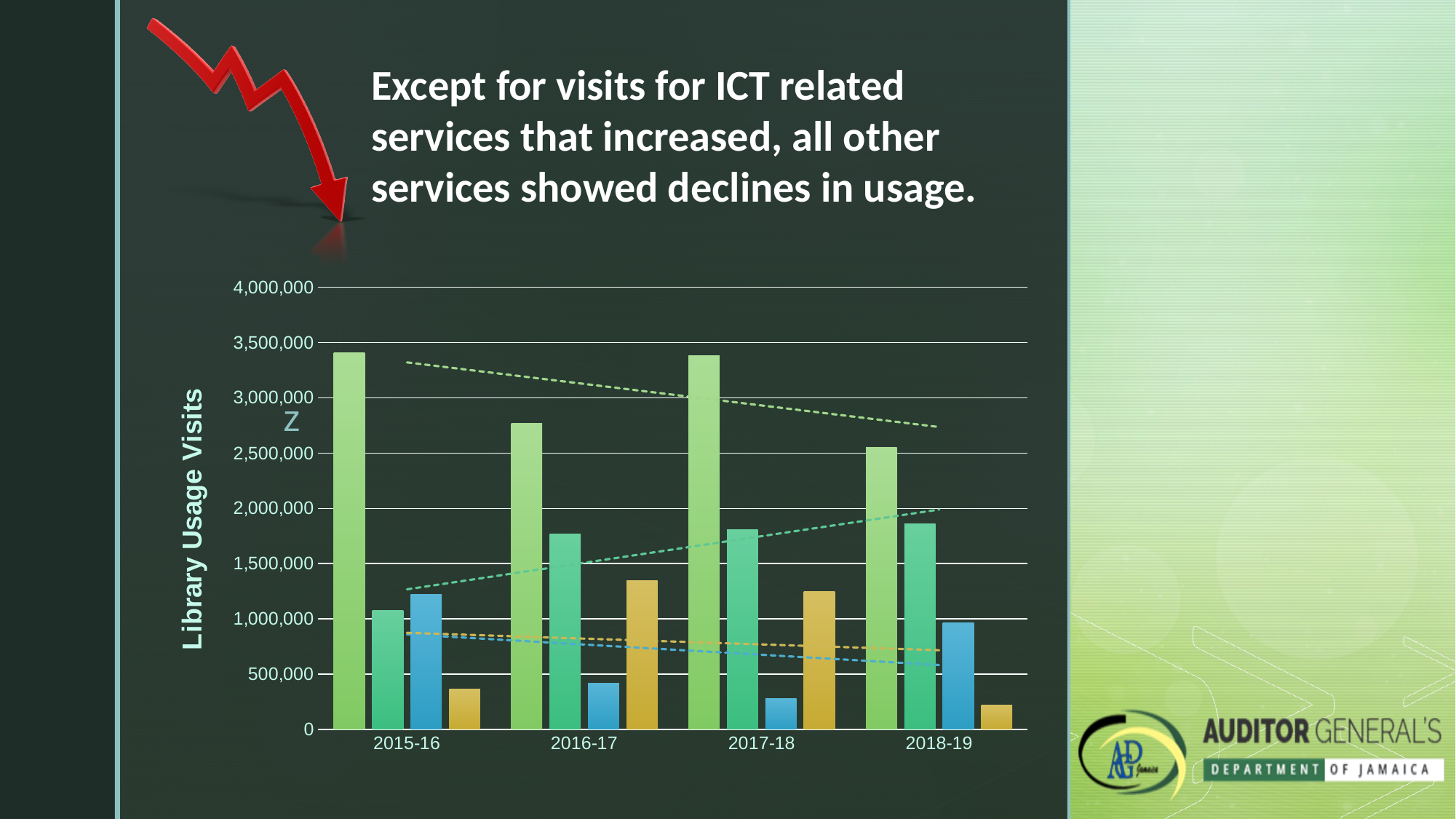
Do the teal bars rise or fall from 2015-16 to 2018-19? rise Which bar is the tallest within the 2015-16 group: the light green, teal, blue or gold bar? light green How many bars are plotted for each year group in the chart? 4 Is the value of the light green bar for 2018-19 greater or less than 2,000,000? greater Is the value of the gold bar for 2016-17 greater or less than 1,500,000? less How many year categories are shown on the x axis of the chart? 4 Is the value of the tallest (light green) bar for 2015-16 greater or less than 3,000,000? greater What kind of chart is shown on the slide? bar chart Which bar is the shortest within the 2018-19 group: the light green, teal, blue or gold bar? gold What is the label on the vertical axis of the chart? Library Usage Visits